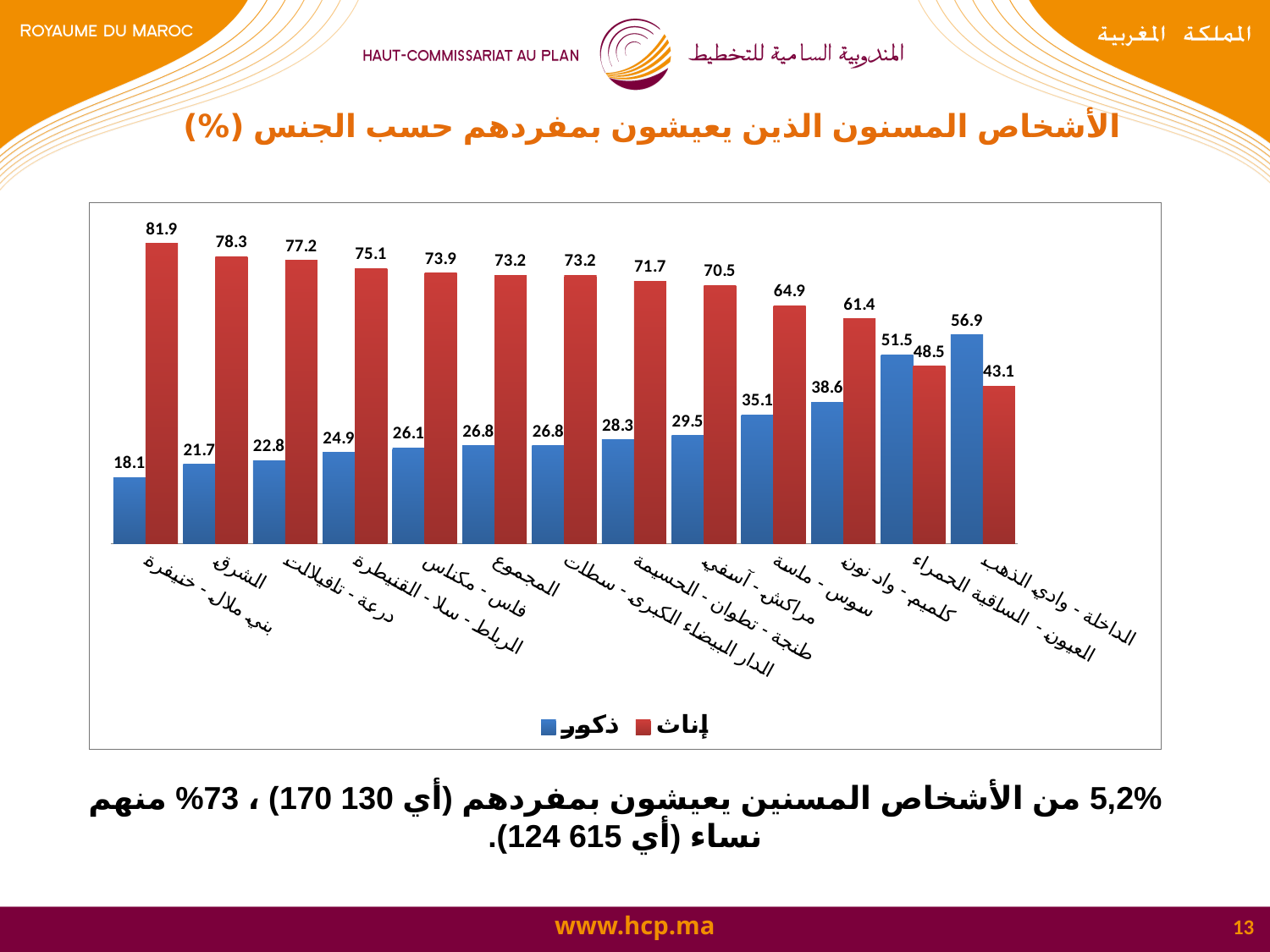
What is the value for ذكور (males) in المجموع? 26.8 How many categories (regions) are shown on the x axis? 13 Which category has the lowest value for ذكور (males)? بني ملال - خنيفرة What is the difference between the إناث and ذكور values in الشرق? 56.6 Which category has the highest value for إناث (females)? بني ملال - خنيفرة What kind of chart is shown on the slide? bar chart In العيون - الساقية الحمراء, which is larger: the value for ذكور or for إناث? ذكور How many series does the legend list? 2 Which colour represents إناث (females) in the chart? red What is the value for إناث (females) in الداخلة - وادي الذهب? 43.1 Do the ذكور (males) values rise or fall moving from left to right along the x axis? rise What is the value for ذكور (males) in بني ملال - خنيفرة? 18.1